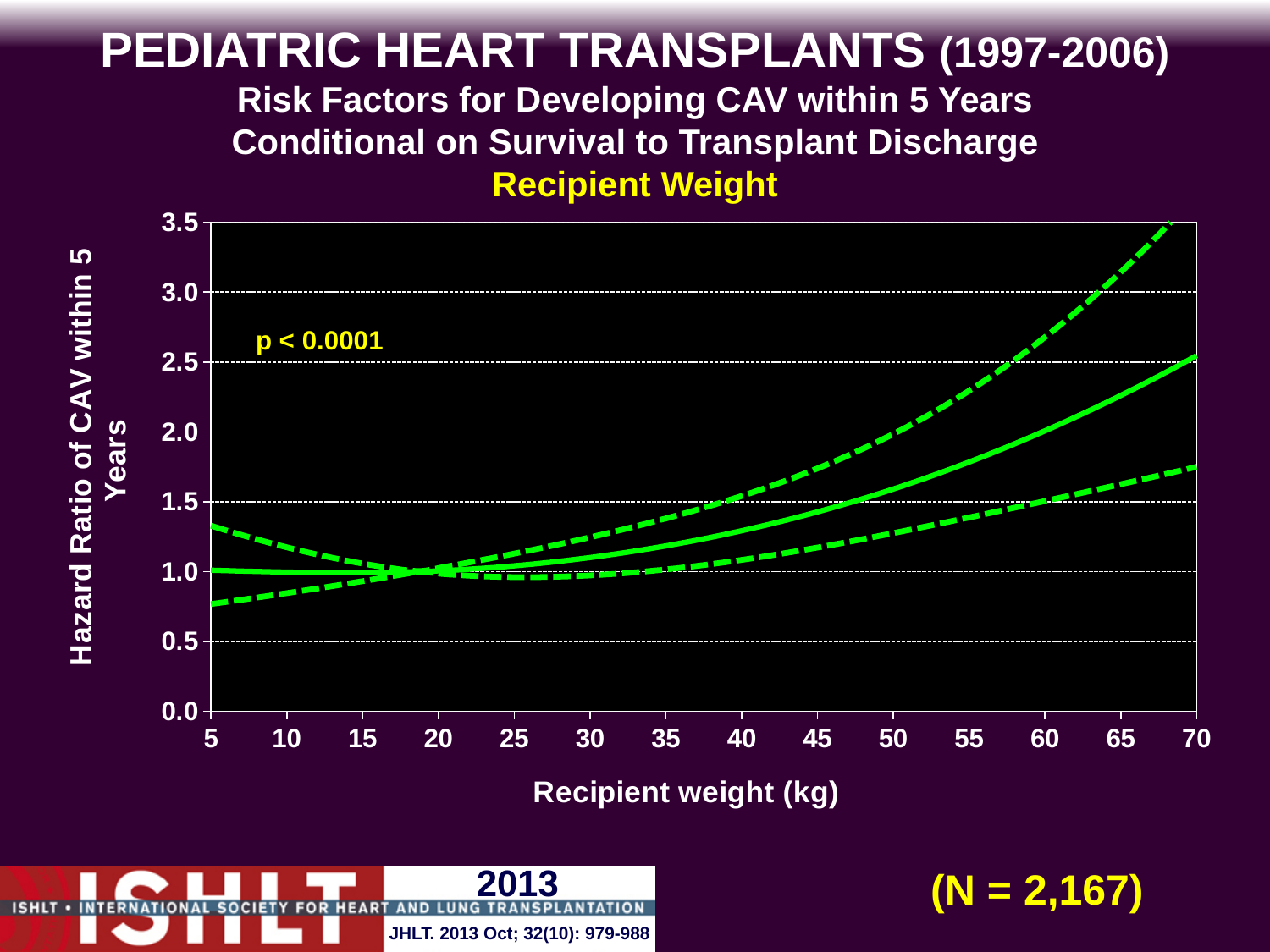
Is the value of the upper dashed line at 65 kg greater or less than 2.5? greater What is the label of the x axis? Recipient weight (kg) Is the value of the solid line at 55 kg greater or less than 2.0? less Is the value of the lower dashed line at 70 kg greater or less than 1.5? greater What is the p-value printed on the chart? p < 0.0001 What kind of chart is shown on the slide? line chart How many lines are plotted on the chart? 3 Does the solid line (hazard ratio) rise or fall as recipient weight increases from 20 kg to 70 kg? rise